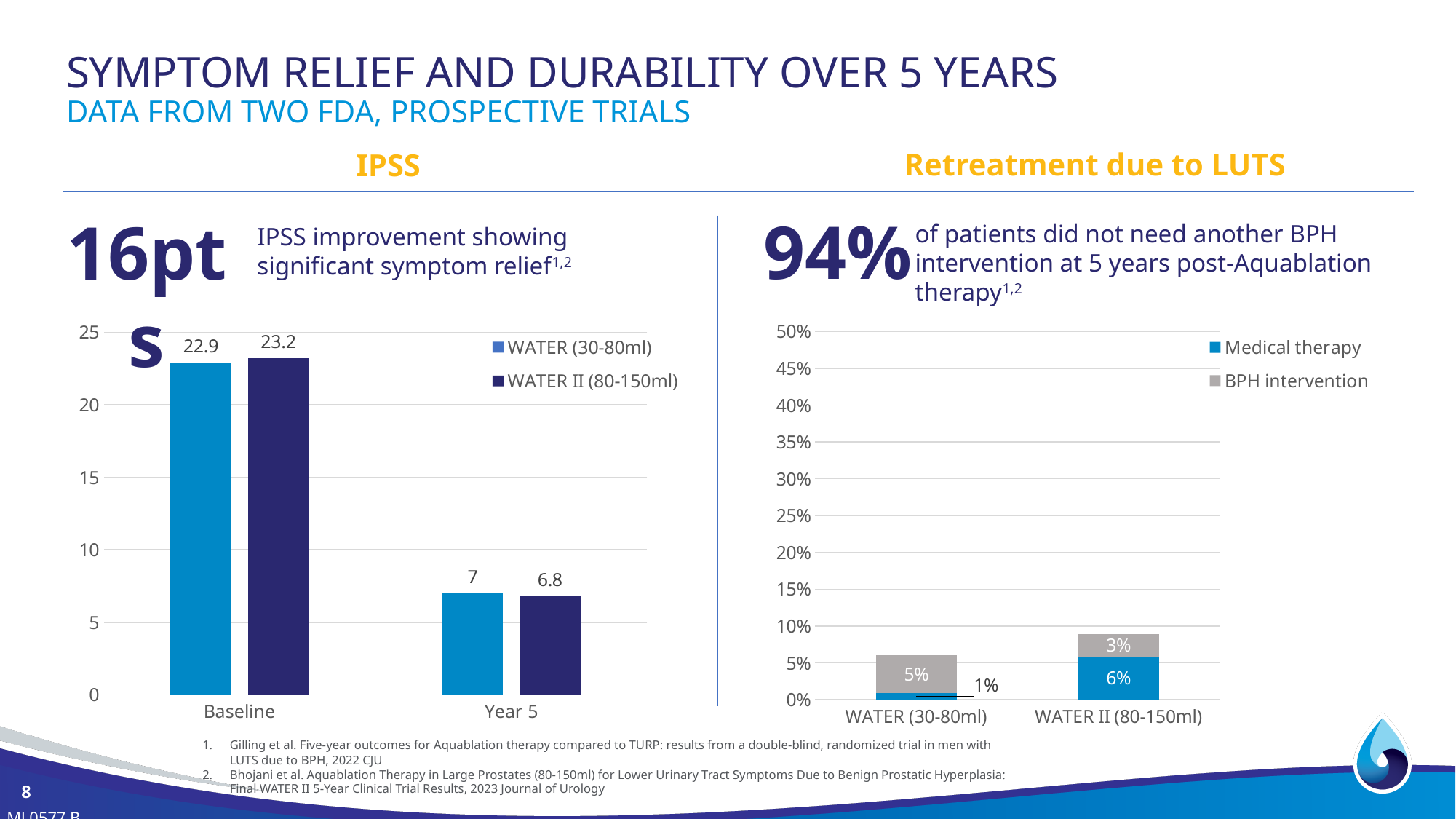
In the IPSS chart, what is the difference between the Baseline and Year 5 values for WATER (30-80ml)? 15.9 In the Retreatment due to LUTS chart, what is the Medical therapy value for WATER II (80-150ml)? 6% What kind of chart is the IPSS chart? bar chart In the IPSS chart, what is the Year 5 value for WATER II (80-150ml)? 6.8 In the IPSS chart, what is the Baseline value for WATER (30-80ml)? 22.9 In the IPSS chart, do the values rise or fall from Baseline to Year 5? fall In the IPSS chart, which series has the higher Baseline value? WATER II (80-150ml) In the Retreatment due to LUTS chart, which series is shown in grey? BPH intervention In the Retreatment due to LUTS chart, how many categories are shown on the x axis? 2 In the Retreatment due to LUTS chart, what is the BPH intervention value for WATER (30-80ml)? 5% In the Retreatment due to LUTS chart, what is the total of the stacked bar for WATER II (80-150ml)? 9% In the IPSS chart, how many series does the legend list? 2